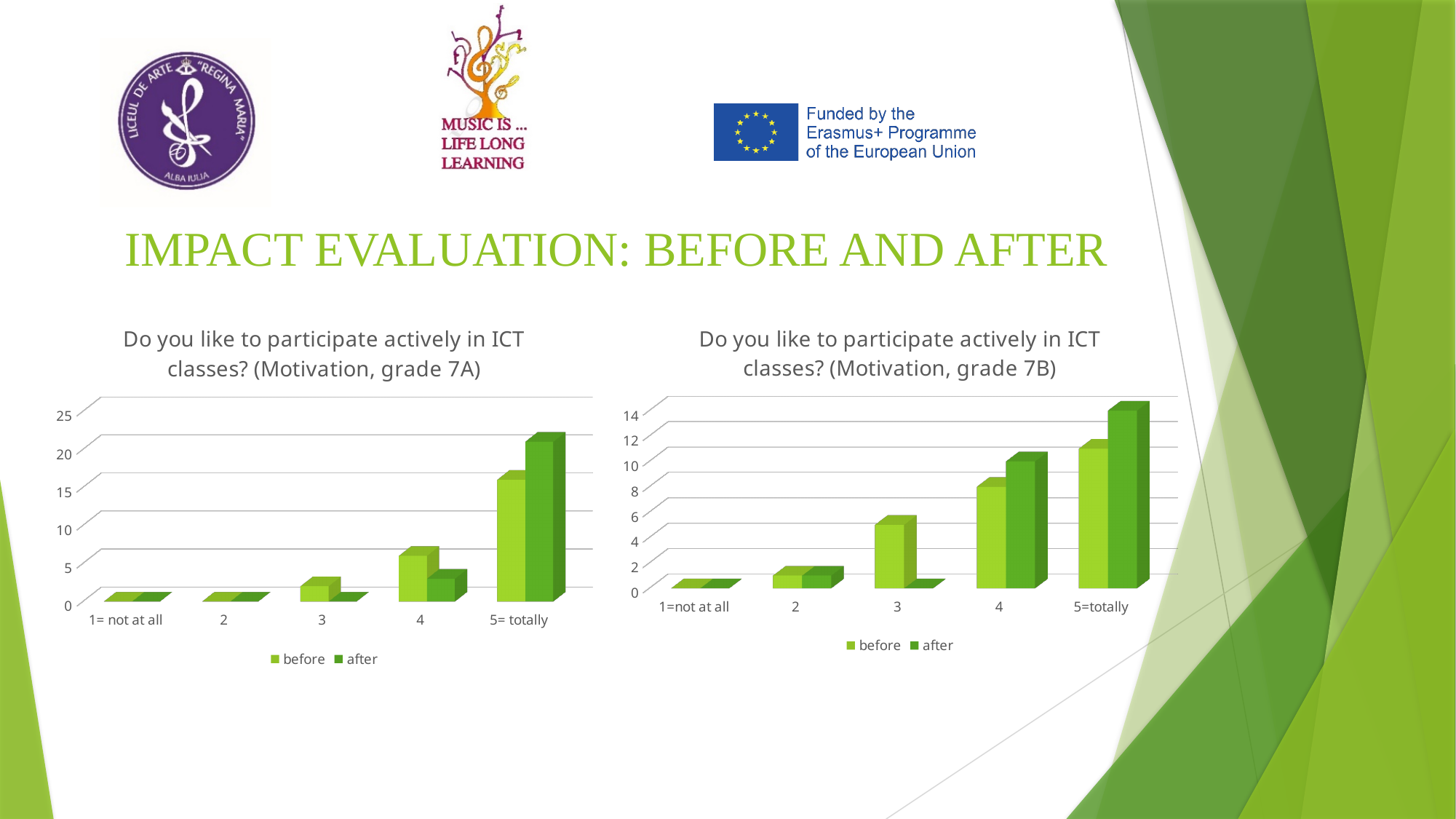
In the grade 7A chart, is the "after" value for "5= totally" greater or less than 15? greater How many categories are shown on the x axis of the grade 7B chart? 5 What are the two legend entries in the grade 7B chart? before, after In the grade 7A chart, for category 4, is the "before" or the "after" value larger? before In the grade 7B chart, is the "after" value for "5=totally" greater or less than 12? greater How many series does the legend of the grade 7A chart list? 2 In the grade 7B chart, which category has the highest "before" value? 5=totally In the grade 7B chart, for category 4, is the "before" or the "after" value larger? after In the grade 7B chart, for category 3, is the "before" or the "after" value larger? before In the grade 7A chart, which category has the highest "after" value? 5= totally What kind of chart is the chart titled "Do you like to participate actively in ICT classes? (Motivation, grade 7A)"? bar chart In the grade 7A chart, is the "before" value for "5= totally" greater or less than 20? less